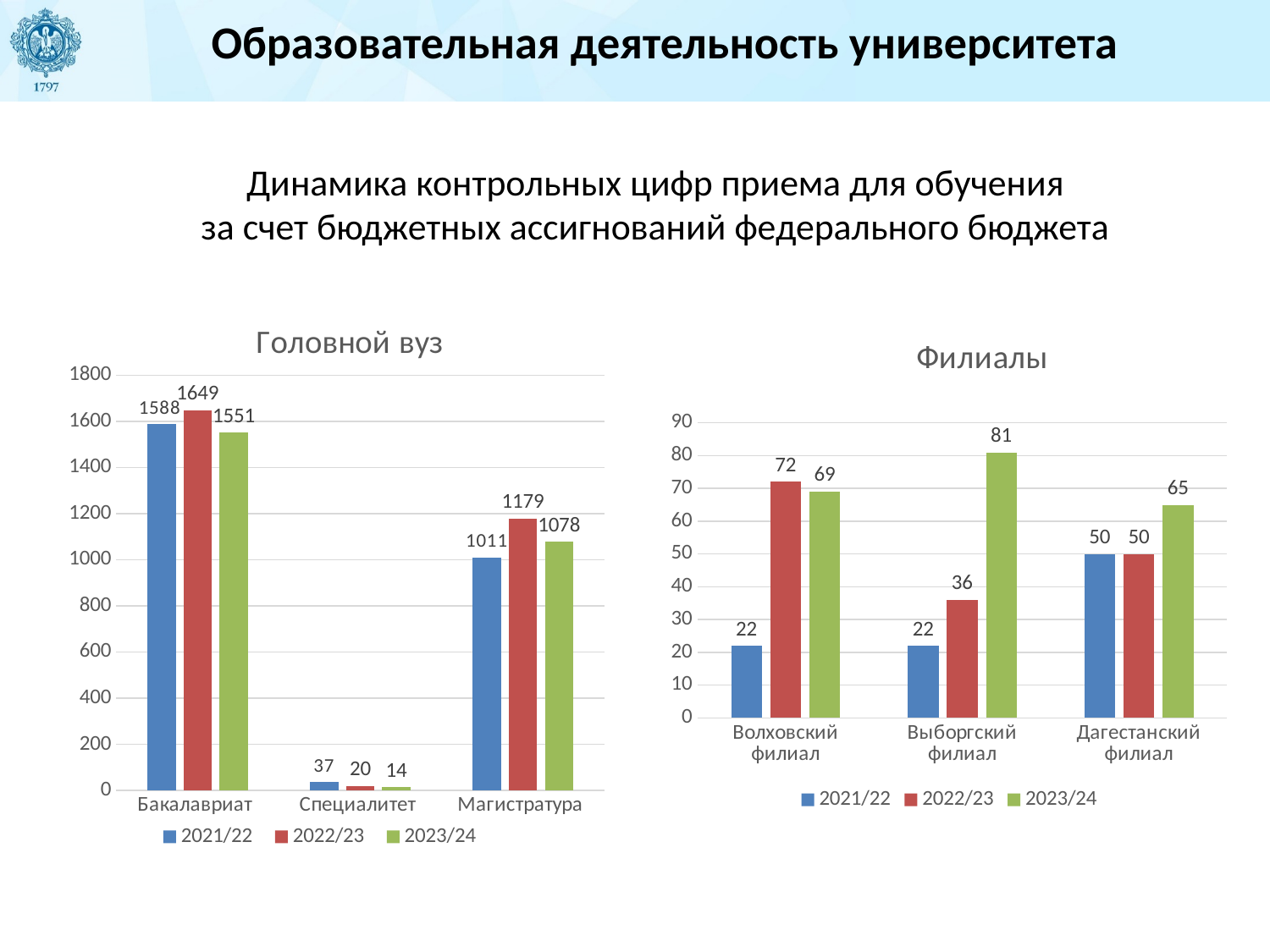
In the 'Филиалы' chart, which branch has the highest value in 2022/23? Волховский филиал In the 'Филиалы' chart, which is larger: the 2023/24 value for Волховский филиал or the 2023/24 value for Дагестанский филиал? Волховский филиал In the 'Головной вуз' chart, which category has the lowest value in 2023/24? Специалитет In the 'Головной вуз' chart, what is the value for Бакалавриат in 2022/23? 1649 What type of chart is the 'Филиалы' chart? bar chart In the 'Головной вуз' chart, what is the value for Магистратура in 2021/22? 1011 In the 'Филиалы' chart, what is the value for Выборгский филиал in 2023/24? 81 In the 'Филиалы' chart, how many branches are shown on the x axis? 3 In the 'Головной вуз' chart, how many series does the legend list? 3 In the 'Головной вуз' chart, what is the difference between the 2022/23 and 2023/24 values for Магистратура? 101 In the 'Головной вуз' chart, do the values for Специалитет rise or fall from 2021/22 to 2023/24? fall In the 'Филиалы' chart, what is the difference between the 2023/24 and 2021/22 values for Дагестанский филиал? 15